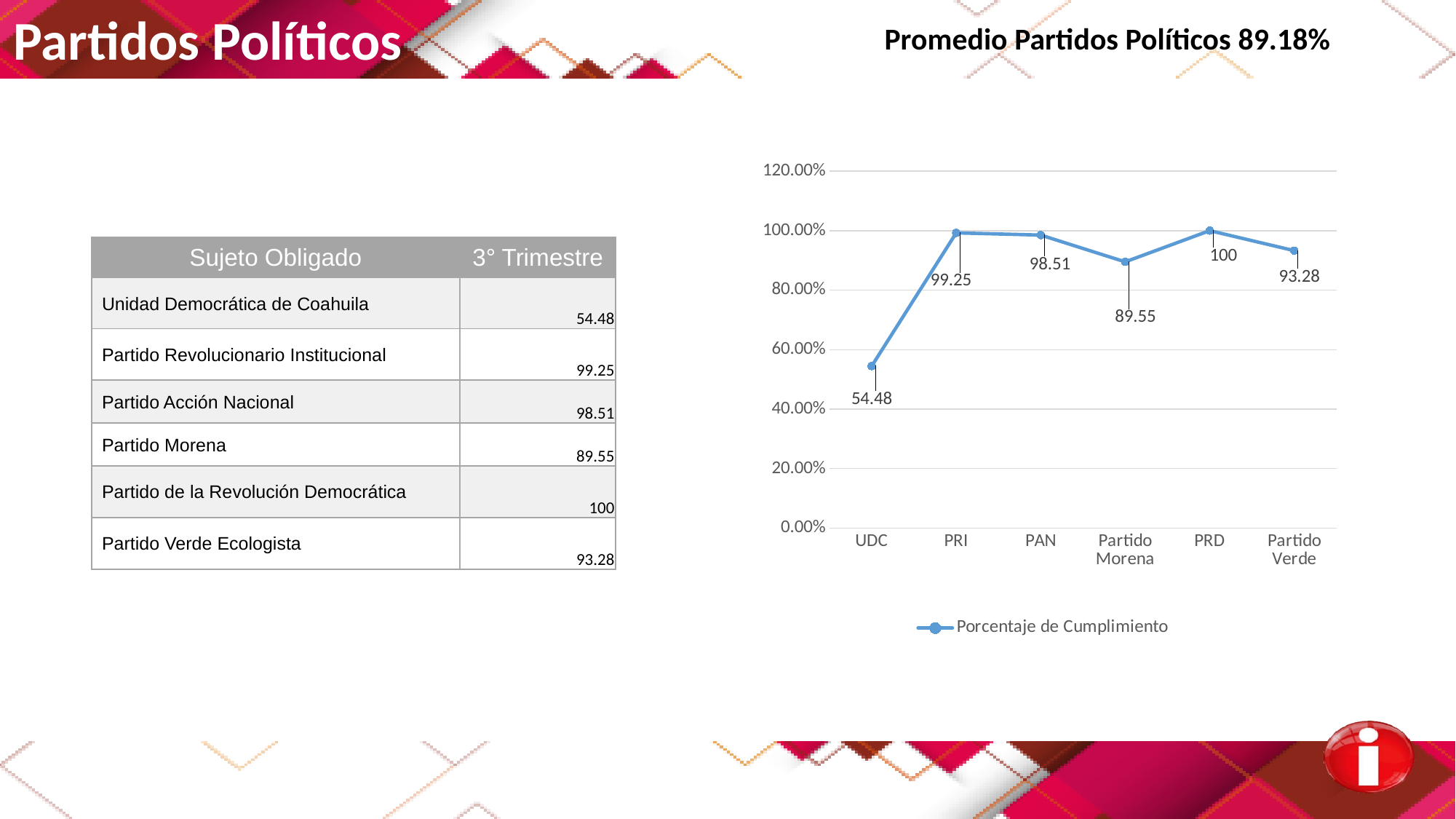
How many categories are plotted on the x axis of the chart? 6 What is the value for Partido Morena in the chart? 89.55 What is the value for PRI in the chart? 99.25 What is the value for Partido Verde in the chart? 93.28 Which category has the lowest value in the chart? UDC Which is larger, the value for PAN or the value for Partido Verde? PAN What is the value for UDC in the chart? 54.48 What series name does the chart legend show? Porcentaje de Cumplimiento Which category has the highest value in the chart? PRD What is the difference between the values for PRD and UDC? 45.52 What kind of chart is shown on the slide? line chart Is the value for UDC greater or less than 60.00%? less